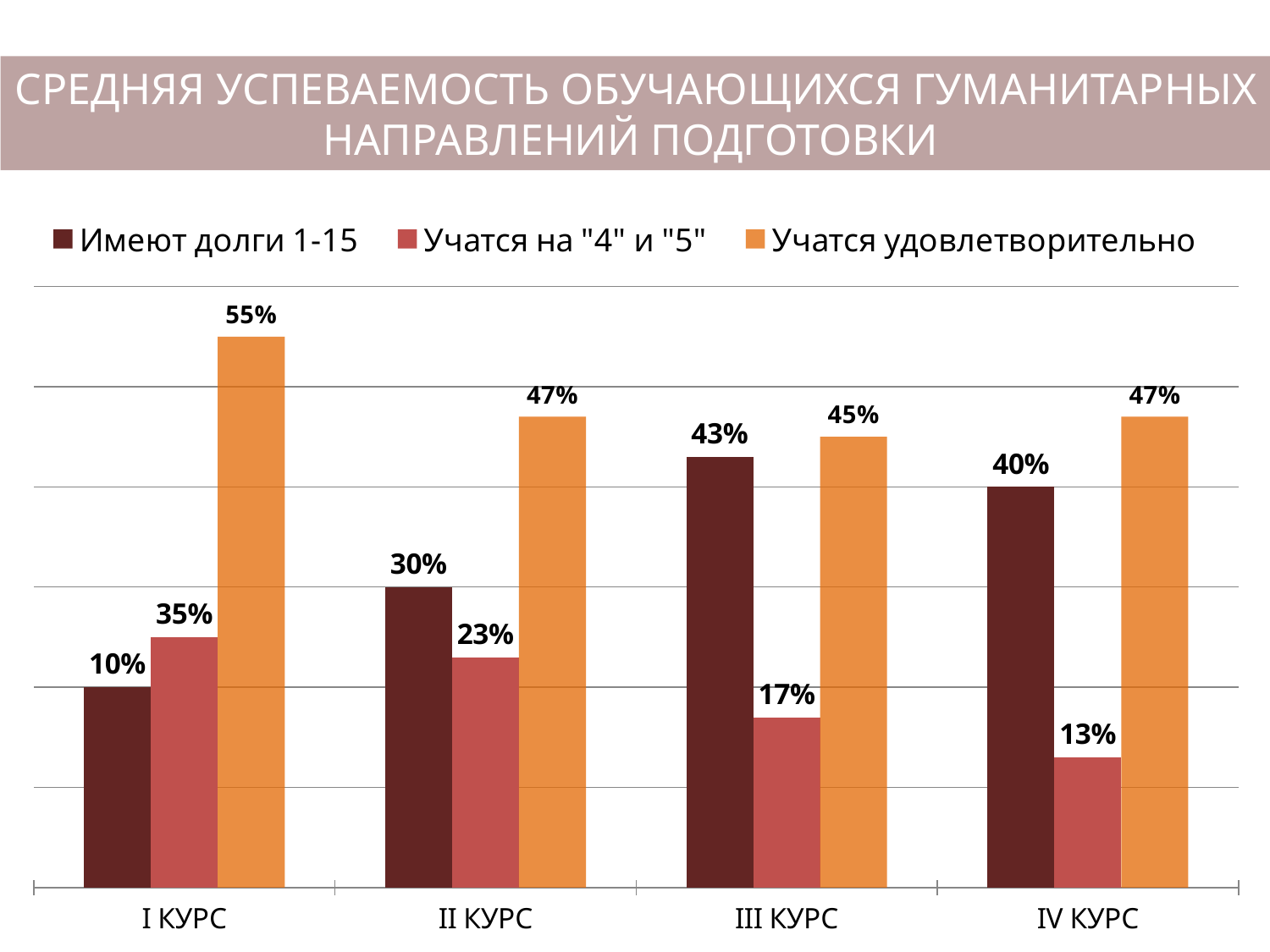
What is the value for "Учатся удовлетворительно" for II КУРС? 47% Which colour represents "Учатся удовлетворительно" in the chart? Orange Which course has the lowest value for "Учатся на "4" и "5""? IV КУРС What is the value for "Учатся на "4" и "5"" for III КУРС? 17% What is the difference between the "Имеют долги 1-15" values for III КУРС and I КУРС? 33% Does the value for "Учатся на "4" и "5"" rise or fall from I КУРС to IV КУРС? Fall How many series does the legend list? 3 How many courses are shown on the x axis? 4 What is the value for "Имеют долги 1-15" for I КУРС? 10% Which is larger for IV КУРС: "Имеют долги 1-15" or "Учатся на "4" и "5""? Имеют долги 1-15 Which course has the highest value for "Учатся удовлетворительно"? I КУРС What kind of chart is shown on the slide? Bar chart